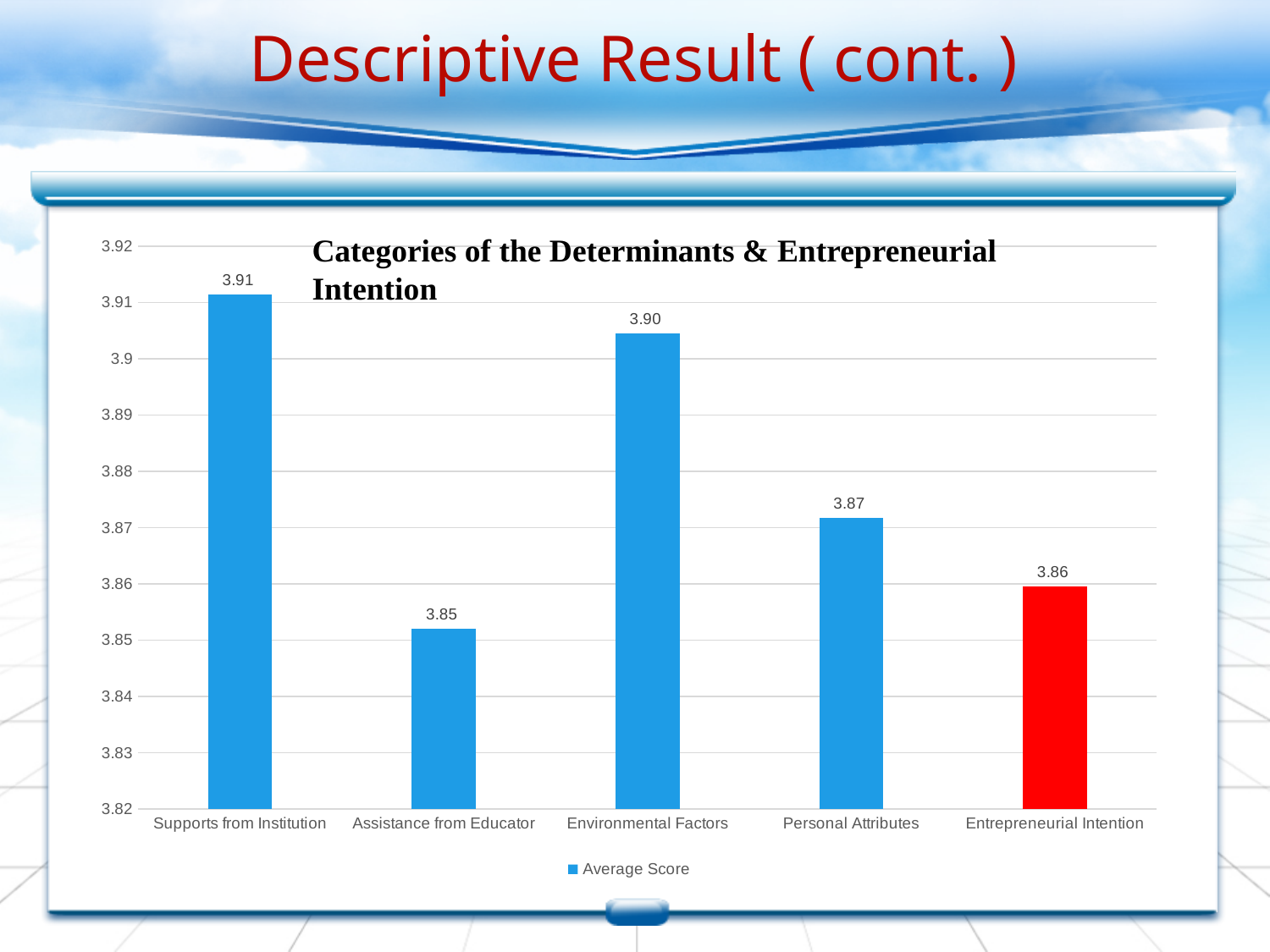
What is the difference between the average scores for Supports from Institution and Assistance from Educator? 0.06 What is the average score for Environmental Factors? 3.90 What type of chart is shown on the slide? Bar chart What is the average score for Personal Attributes? 3.87 What is the average score for Entrepreneurial Intention? 3.86 Which category has the highest average score? Supports from Institution How many categories are shown on the chart? 5 Which category's bar is coloured red? Entrepreneurial Intention What is the average score for Assistance from Educator? 3.85 What is the average score for Supports from Institution? 3.91 Which category has the lowest average score? Assistance from Educator Which has a higher average score, Personal Attributes or Entrepreneurial Intention? Personal Attributes